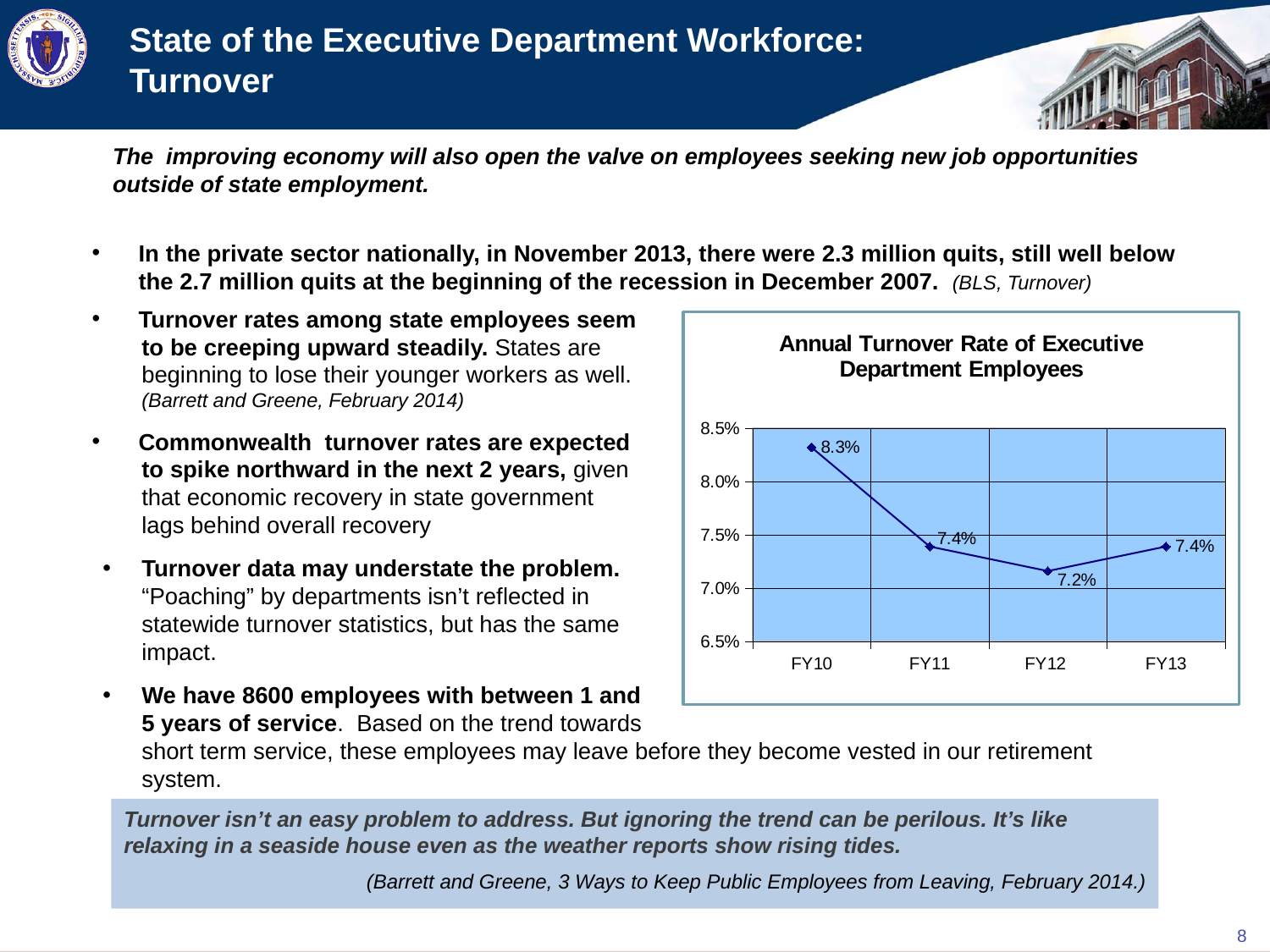
What is the title of the chart? Annual Turnover Rate of Executive Department Employees Which fiscal year has the lowest turnover rate? FY12 What kind of chart is shown on the slide? line chart What is the annual turnover rate for FY10? 8.3% How many fiscal years are plotted on the chart? 4 Is the turnover rate for FY10 greater or less than 8.0%? greater What is the annual turnover rate for FY12? 7.2% What is the difference between the turnover rate in FY12 and FY13? 0.2% What is the annual turnover rate for FY13? 7.4% Which fiscal year has the highest turnover rate? FY10 What is the difference between the turnover rate in FY10 and FY11? 0.9% Which is larger, the turnover rate in FY10 or FY13? FY10